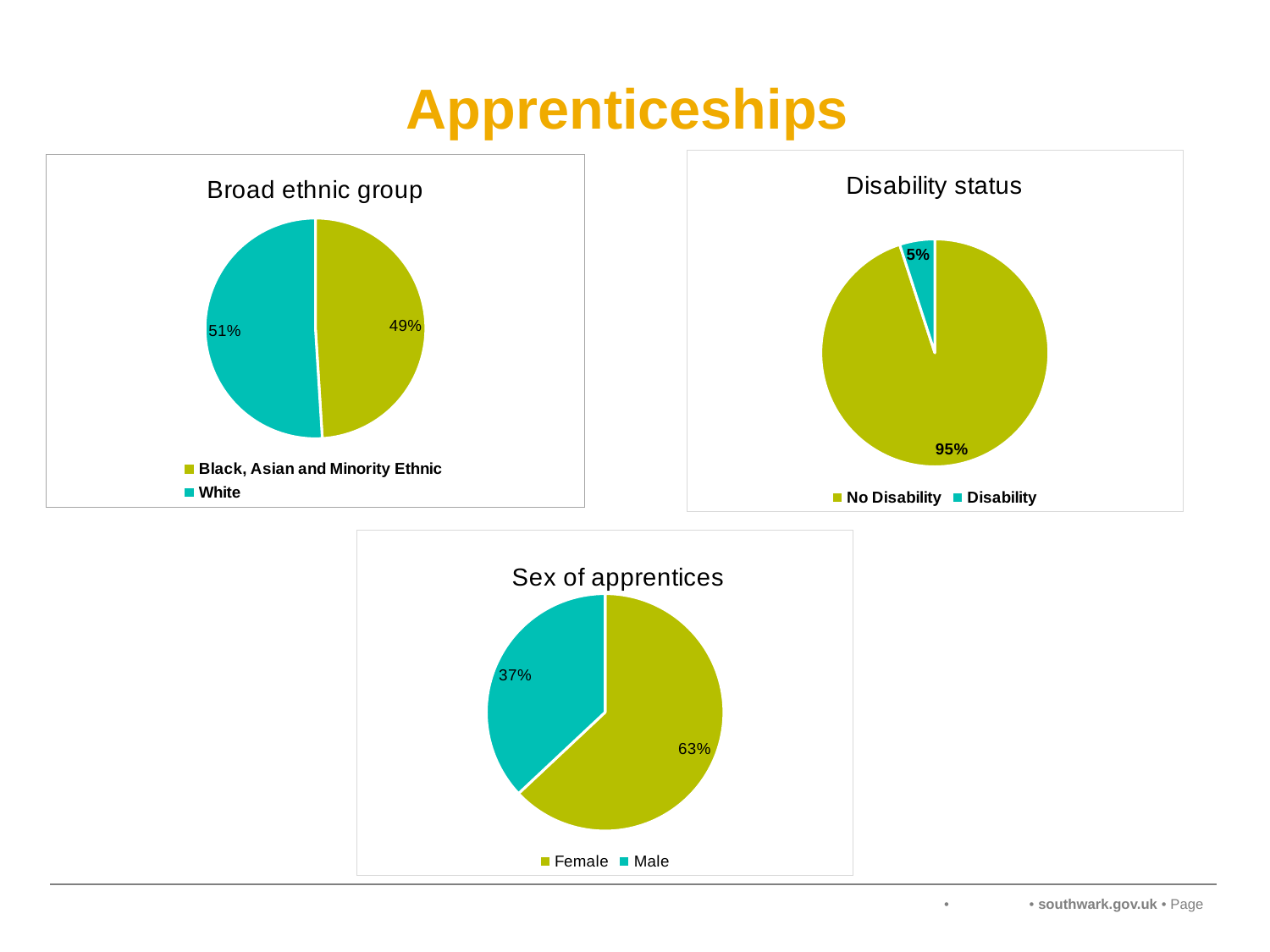
In the Disability status chart, what is the difference between the No Disability and Disability shares? 90% In the Sex of apprentices chart, what is the difference between the Female and Male shares? 26% In the Disability status chart, what percentage of apprentices have no disability? 95% In the Broad ethnic group chart, what share of apprentices are Black, Asian and Minority Ethnic? 49% In the Broad ethnic group chart, what share of apprentices are White? 51% What type of chart is the Broad ethnic group chart? Pie chart How many categories does the legend of the Broad ethnic group chart list? 2 In the Disability status chart, what percentage of apprentices have a disability? 5% In the Sex of apprentices chart, which category has the larger share? Female In the Sex of apprentices chart, what share of apprentices are Female? 63% In the Sex of apprentices chart, what share of apprentices are Male? 37% In the Disability status chart, which category has the smallest share? Disability